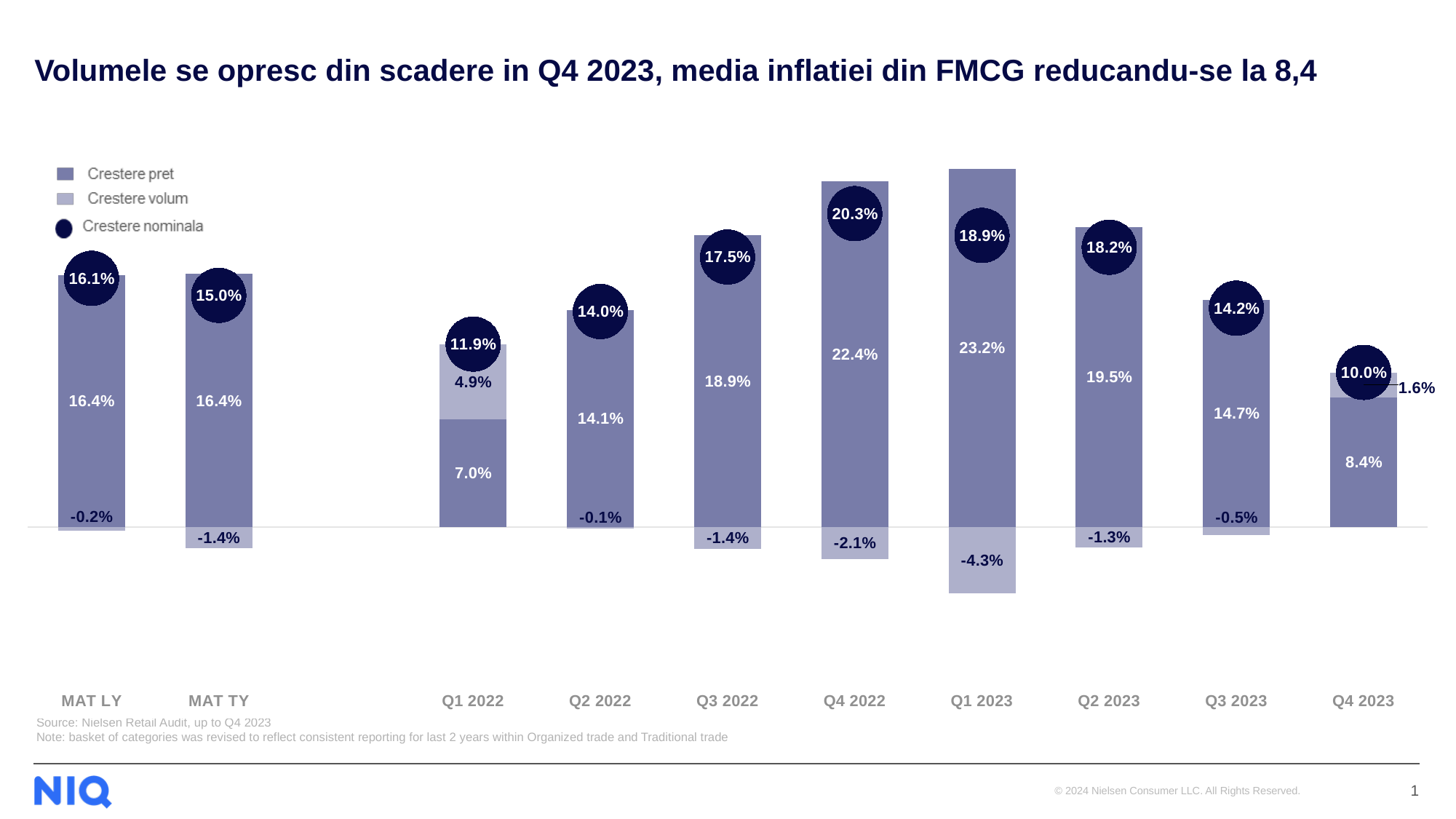
What is the difference between the Crestere pret values for Q4 2022 and Q4 2023? 14.0% Does the Crestere pret value rise or fall from Q1 2023 to Q4 2023? Fall Which period has the lowest Crestere nominala value? Q4 2023 What kind of chart is shown on the slide? Stacked bar chart What is the Crestere nominala value for Q4 2022? 20.3% Which is larger, the Crestere nominala value for Q3 2022 or for Q2 2023? Q2 2023 Which period has the lowest Crestere volum value? Q1 2023 What is the Crestere pret value for Q1 2023? 23.2% What is the Crestere volum value for Q4 2023? 1.6% Which period has the highest Crestere pret value? Q1 2023 How many periods are shown on the x axis? 10 How many series does the legend list? 3